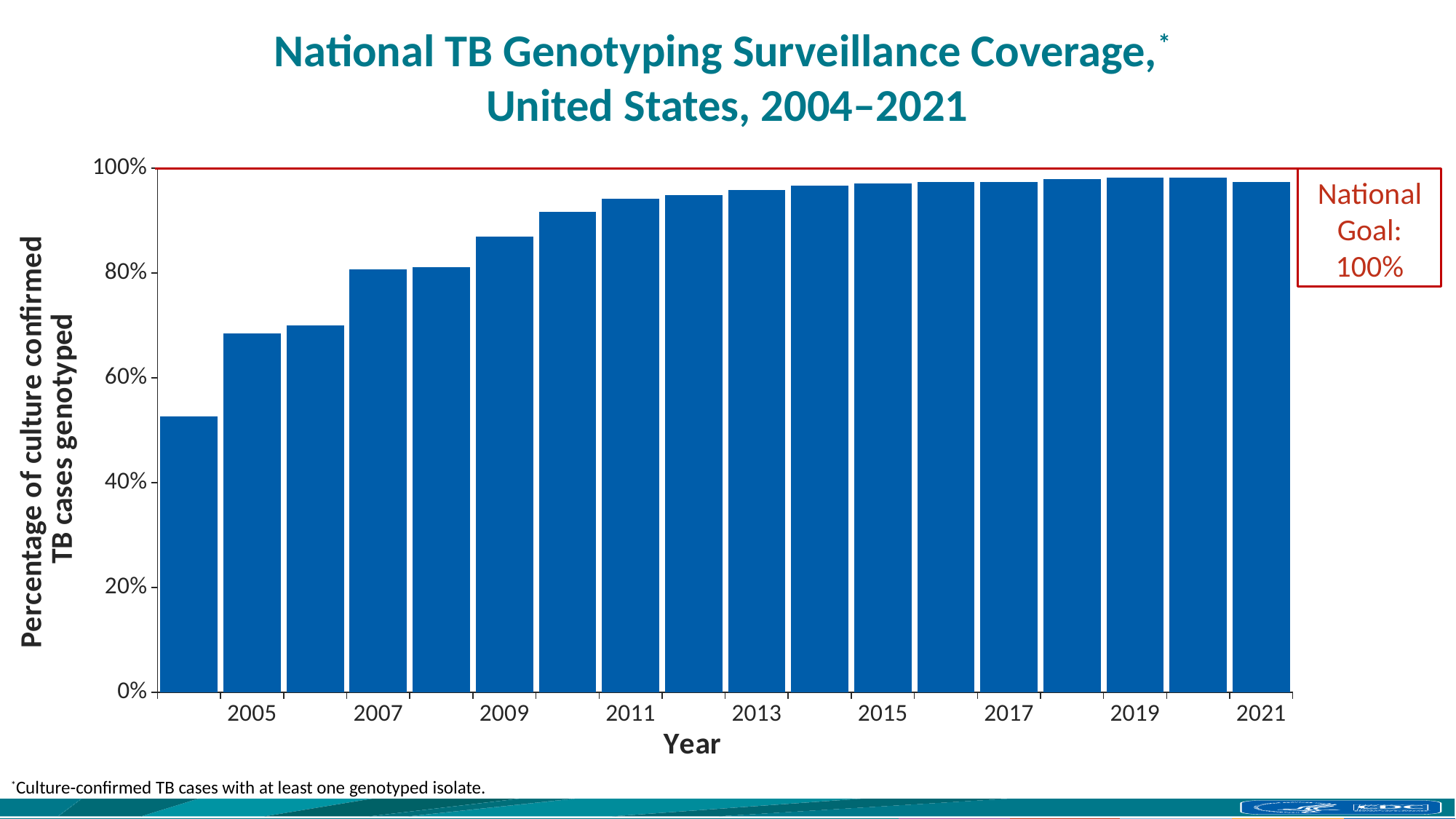
Is the value for 2005 greater or less than 60%? greater How many years (bars) are plotted in the chart? 18 Is the value for 2004 greater or less than 60%? less Is the value for 2009 greater or less than 80%? greater Which year has the larger value, 2005 or 2009? 2009 What kind of chart is shown on the slide? bar chart What is the National Goal shown on the chart? 100% Which year has the lowest percentage of culture-confirmed TB cases genotyped? 2004 Do the values generally rise or fall from 2004 to 2021? rise What is the label of the x axis? Year